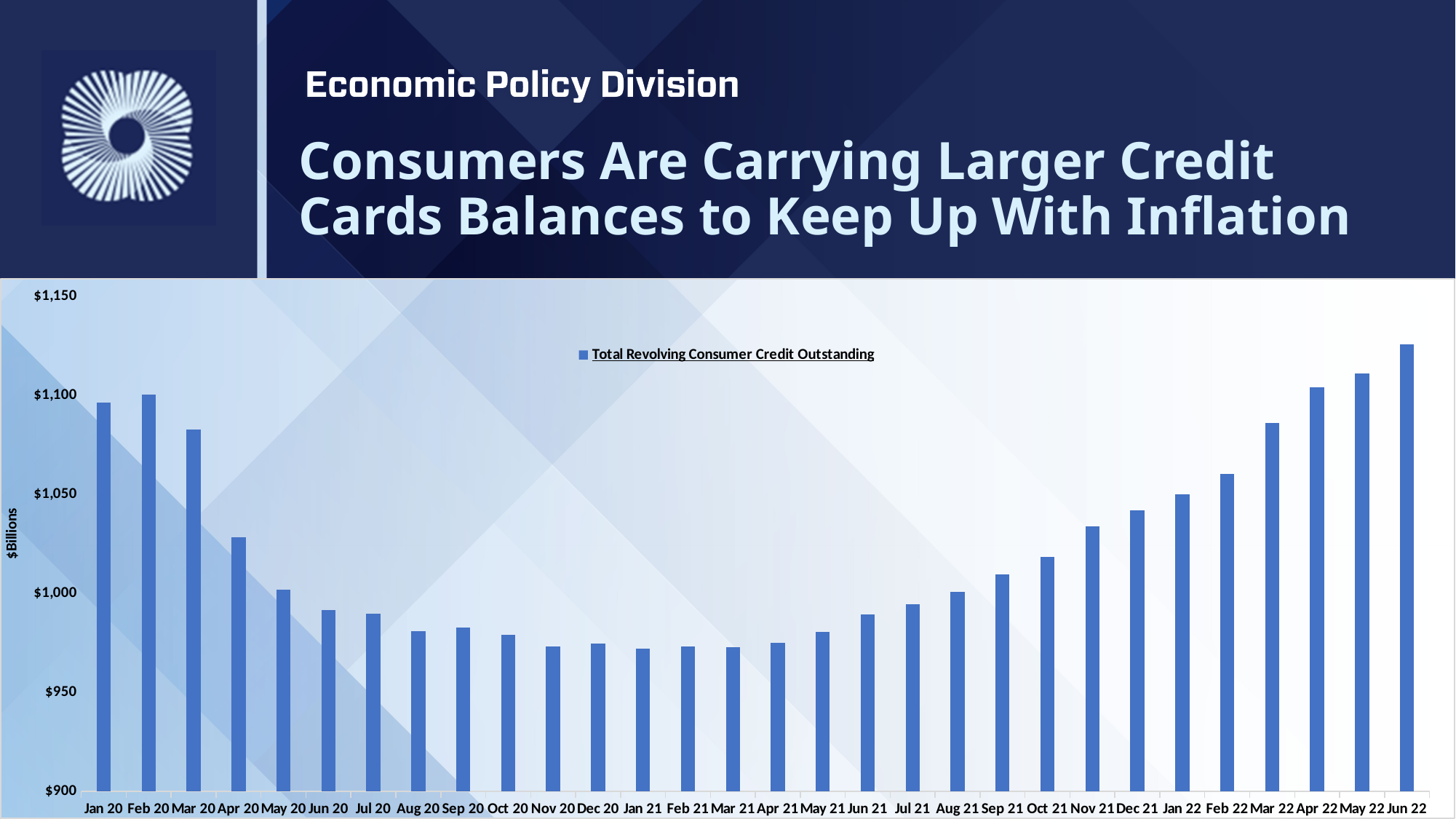
Is the value for Apr 20 greater or less than $1,000? greater Is the value for Jan 20 greater or less than $1,050? greater Is the value for Jun 22 greater or less than $1,100? greater Do the values rise or fall from Jan 21 to Jun 22? rise Which is larger, the value for Mar 20 or the value for Apr 20? Mar 20 What kind of chart is shown on the slide? Bar chart How many series does the legend list? 1 What is the name of the series shown in the legend? Total Revolving Consumer Credit Outstanding How many months (bars) are plotted on the chart? 30 What unit is shown on the vertical axis label? $Billions Which month has the highest value? Jun 22